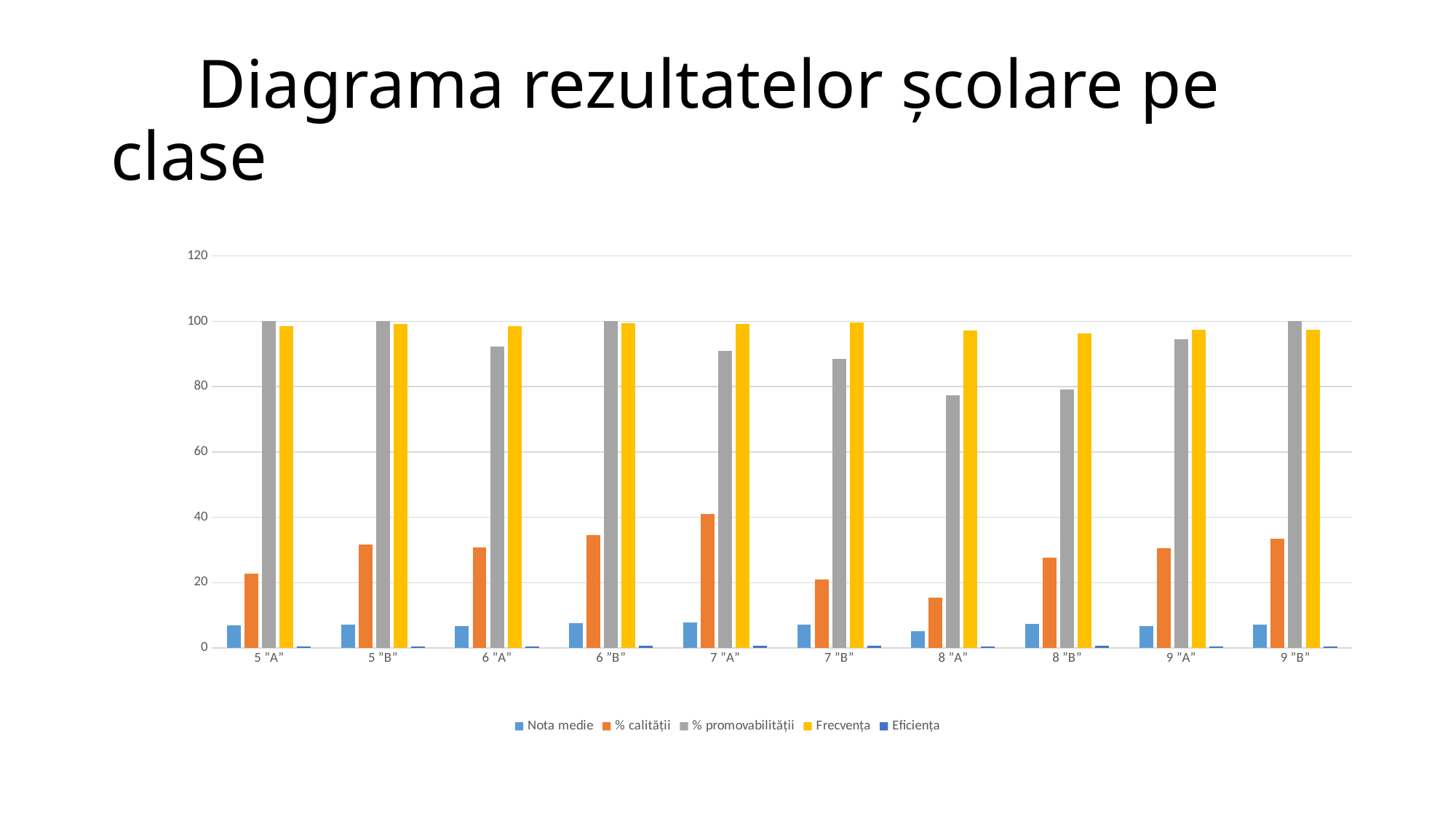
Is the value of % promovabilității for 8 "A" greater or less than 80? less Which class has the highest value for % calității? 7 "A" Which is larger, % calității for 7 "A" or for 7 "B"? 7 "A" How many classes (categories) are shown on the x axis? 10 Which is larger, % promovabilității for 6 "A" or for 8 "A"? 6 "A" What kind of chart is shown on the slide? bar chart What is the title of the chart on the slide? Diagrama rezultatelor școlare pe clase Which class has the lowest value for % calității? 8 "A" How many series does the legend list? 5 Is the value of % calității for 8 "A" greater or less than 20? less Which series is shown in yellow in the legend? Frecvența Is the value of % calității for 7 "A" greater or less than 20? greater